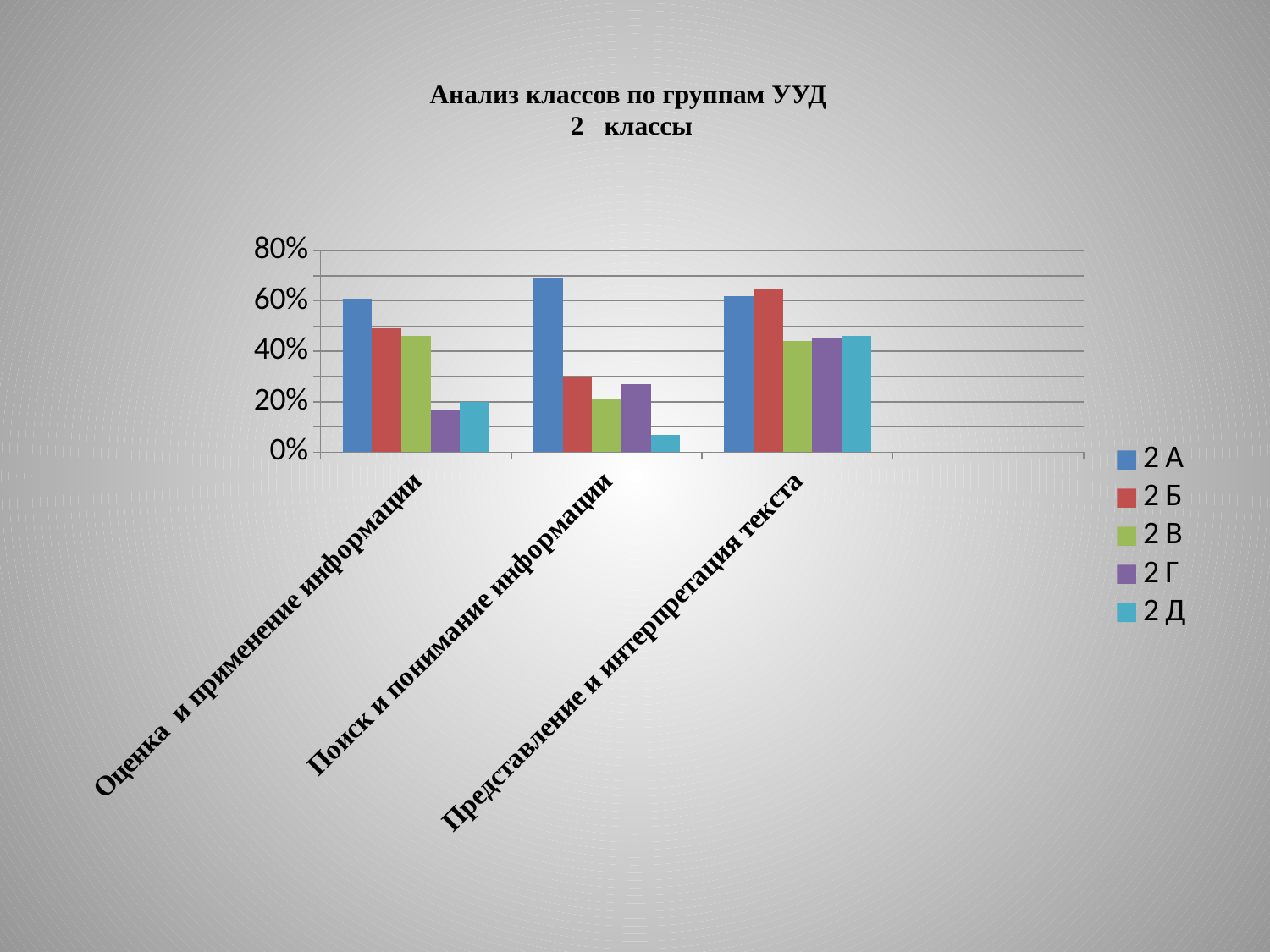
Which class has the highest value for "Поиск и понимание информации"? 2 А What is the title of the chart? Анализ классов по группам УУД 2 классы Which class has the highest value for "Оценка и применение информации"? 2 А Is the value for 2 Д in "Поиск и понимание информации" greater or less than 10%? less Is the value for 2 В in "Оценка и применение информации" greater or less than 40%? greater In "Оценка и применение информации", which is larger: the value for 2 Б or for 2 Д? 2 Б In "Поиск и понимание информации", which is larger: the value for 2 Г or for 2 В? 2 Г How many categories are shown on the x axis? 3 How many series does the legend list? 5 Is the value for 2 А in "Поиск и понимание информации" greater or less than 60%? greater Which class has the lowest value for "Поиск и понимание информации"? 2 Д What kind of chart is shown on the slide? bar chart